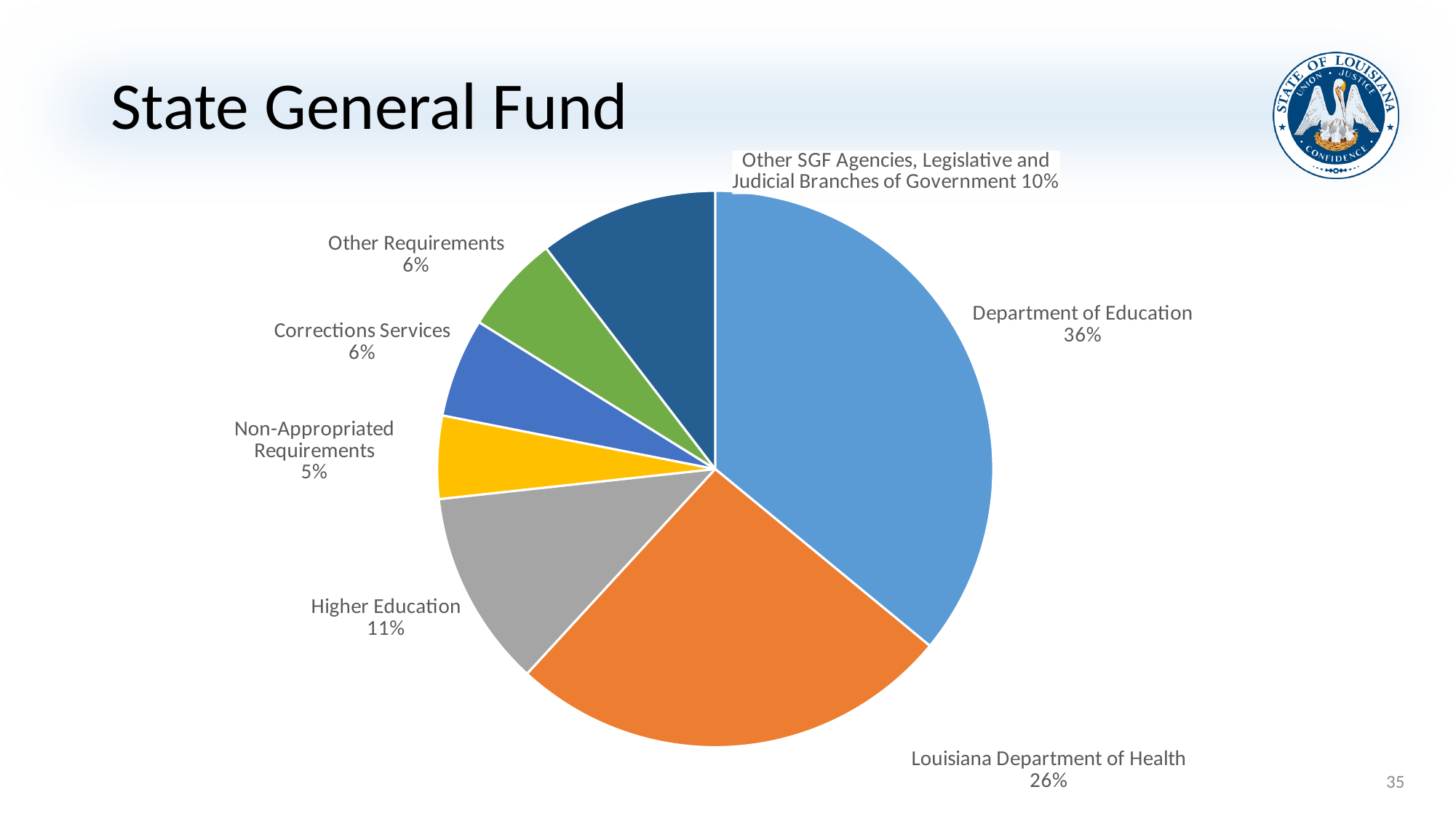
What share of the State General Fund goes to the Department of Education? 36% Which is larger, the share for Higher Education or the share for Corrections Services? Higher Education What percentage is shown for Higher Education? 11% What percentage is shown for Non-Appropriated Requirements? 5% What percentage is shown for Other SGF Agencies, Legislative and Judicial Branches of Government? 10% What is the difference in percentage points between the Department of Education and the Louisiana Department of Health? 10 Which category has the smallest share of the pie? Non-Appropriated Requirements What is the title of the slide containing the chart? State General Fund What type of chart is shown on the slide? Pie chart Which category has the largest share of the pie? Department of Education How many categories are shown in the pie chart? 7 What percentage is shown for the Louisiana Department of Health? 26%